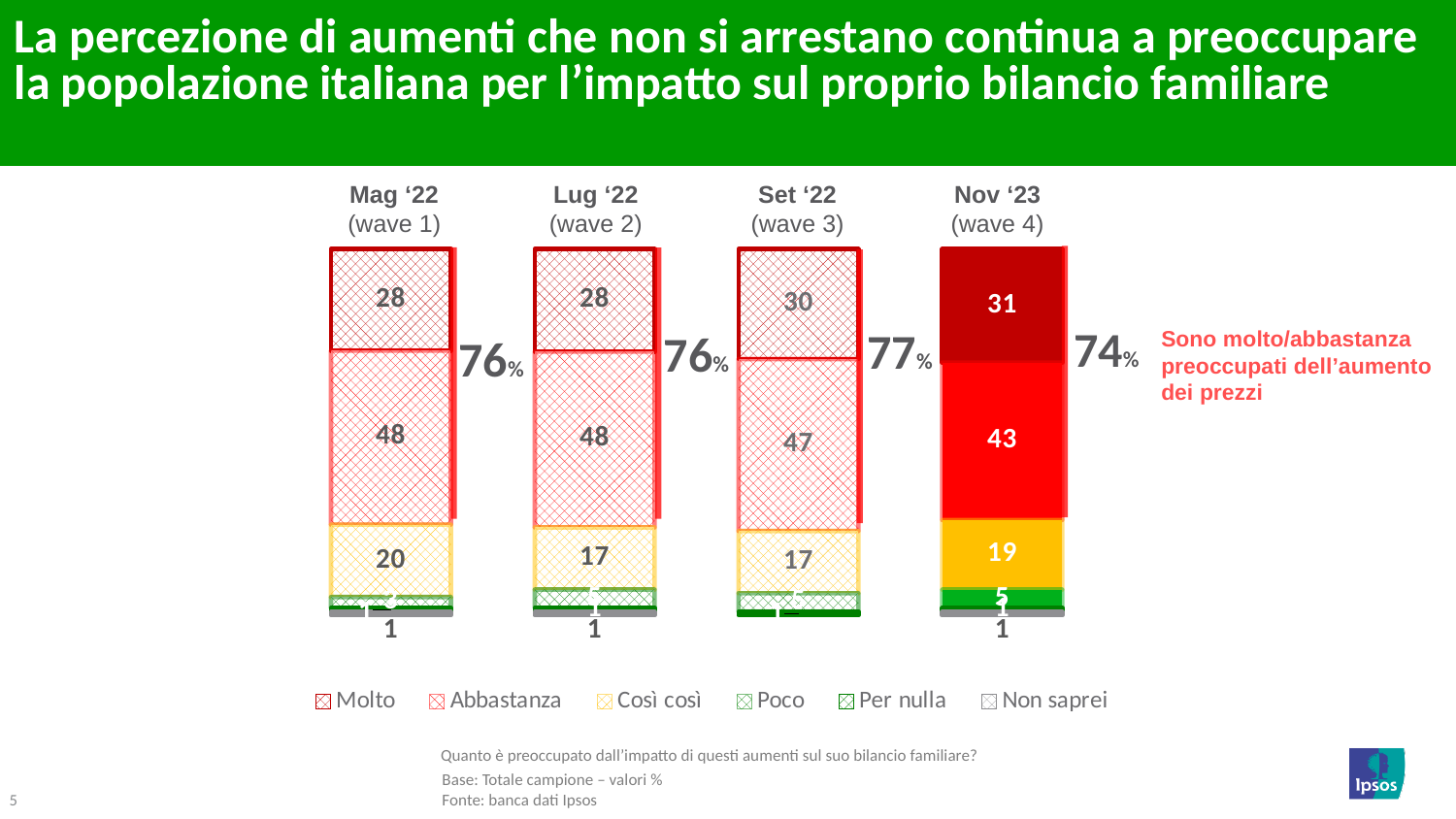
Which is larger: the "Così così" value in Mag '22 (wave 1) or in Nov '23 (wave 4)? Mag '22 (wave 1) What kind of chart is shown on the slide? Stacked bar chart What is the difference between the "Abbastanza" values for Set '22 (wave 3) and Nov '23 (wave 4)? 4 What is the value for "Abbastanza" in Mag '22 (wave 1)? 48 How many waves (bars) are shown in the chart? 4 How many series does the legend list? 6 In which wave is the "Molto" value highest? Nov '23 (wave 4) What is the value for "Molto" in Nov '23 (wave 4)? 31 What is the value for "Molto" in Set '22 (wave 3)? 30 What is the value for "Così così" in Lug '22 (wave 2)? 17 What combined percentage of molto/abbastanza preoccupati is shown for Set '22 (wave 3)? 77% In which wave is the "Abbastanza" value lowest? Nov '23 (wave 4)